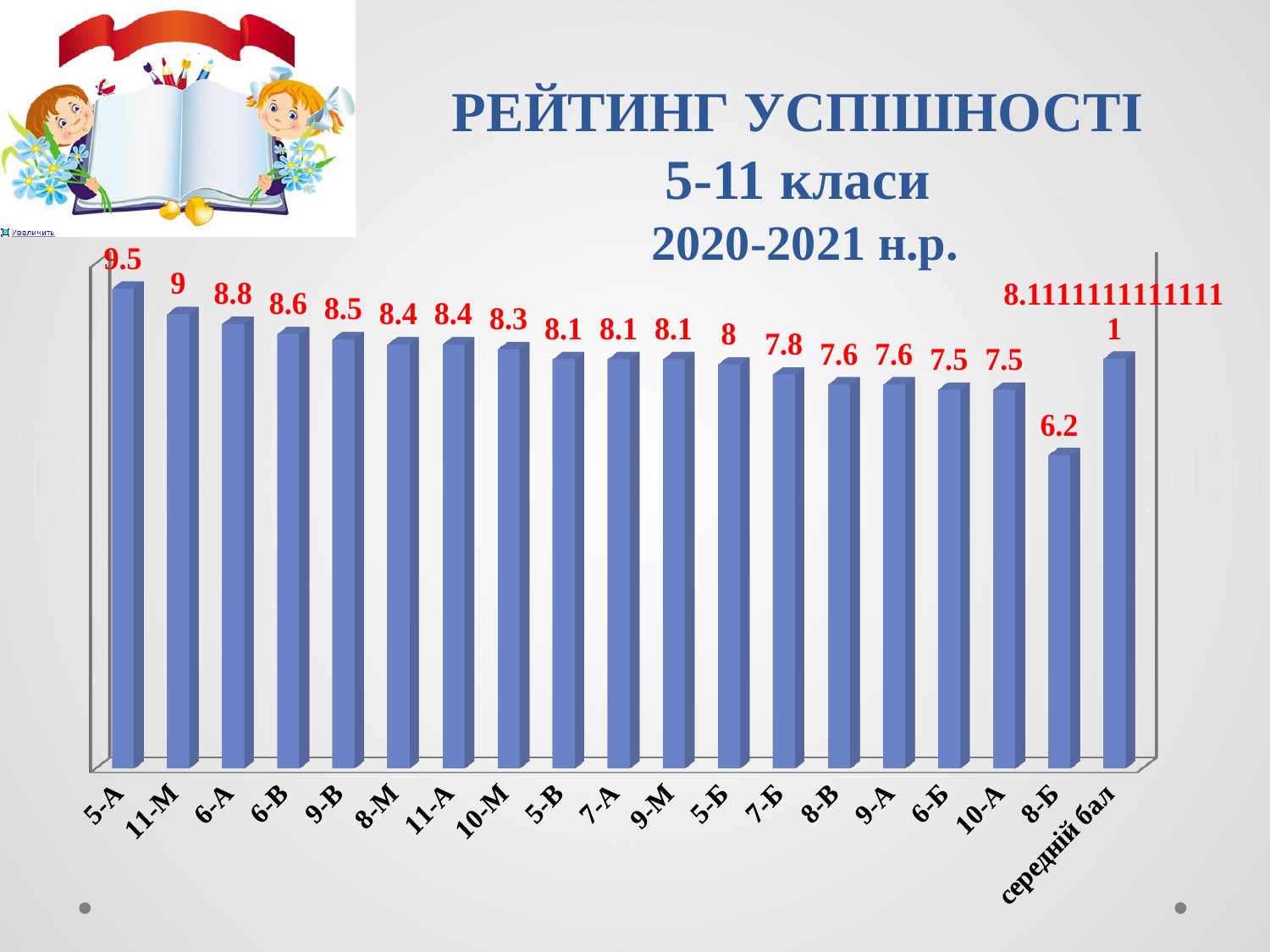
What value is shown for class 7-Б? 7.8 What type of chart is shown on the slide? Bar chart How many bars are plotted on the chart? 19 What value is shown for class 10-М? 8.3 Do the values for the classes generally rise or fall from left to right (excluding the final average bar)? Fall Which has a larger value, 6-В or 9-А? 6-В Which class has the lowest value on the chart? 8-Б Which class has the highest value on the chart? 5-А What value is shown for class 5-А? 9.5 What is the difference between the values for 11-М and 6-А? 0.2 What is the difference between the values for 5-А and 8-Б? 3.3 What value is shown for class 8-Б? 6.2